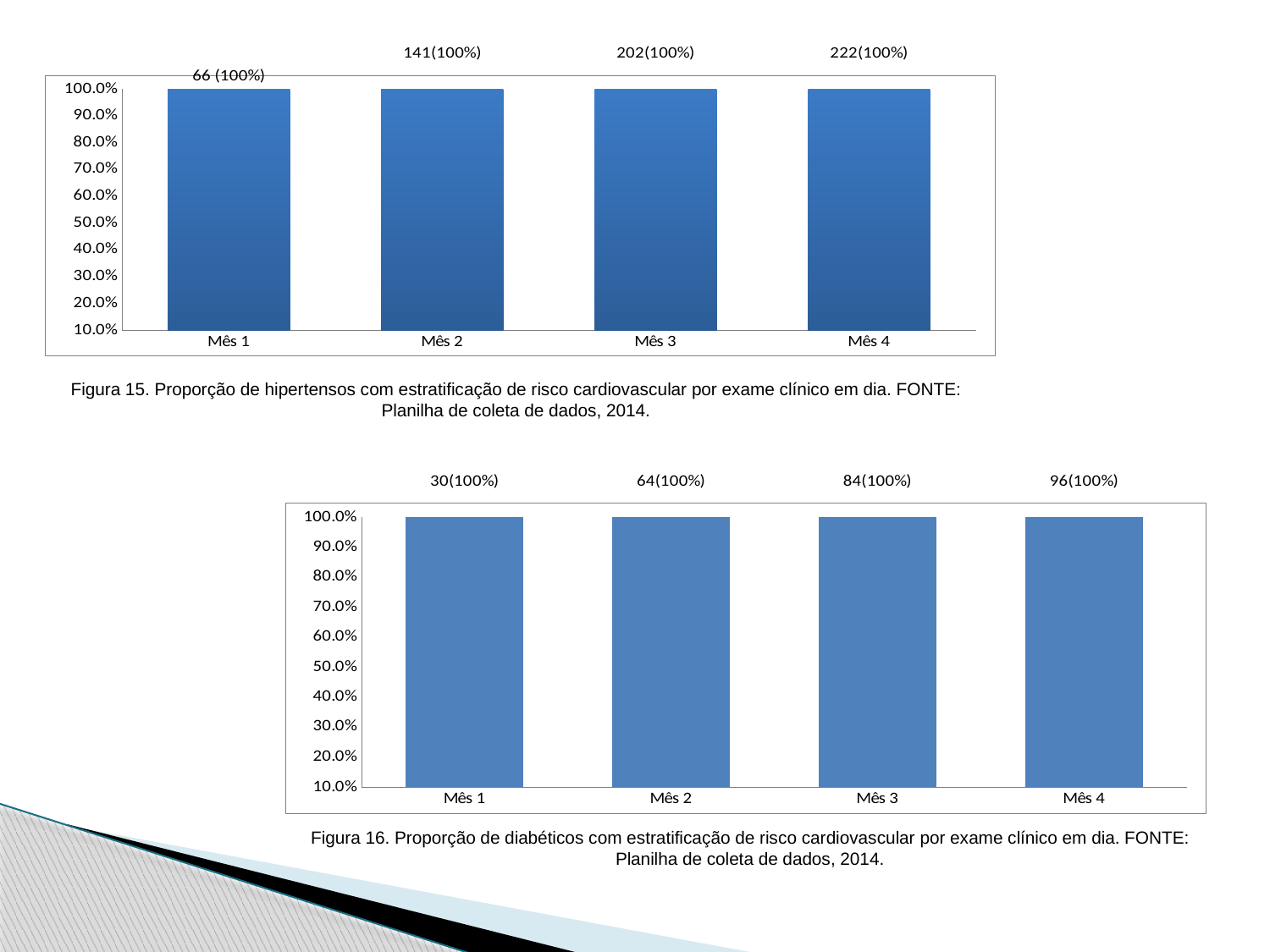
How many categories (months) are shown on the x axis of the top chart (Figura 15)? 4 What kind of chart is the bottom chart (Figura 16)? Bar chart In the bottom chart (Figura 16), what is the data label shown above the bar for Mês 3? 84(100%) In the top chart (Figura 15), what is the data label shown above the bar for Mês 2? 141(100%) In the top chart (Figura 15), what is the data label shown above the bar for Mês 1? 66 (100%) In the bottom chart (Figura 16), what is the data label shown above the bar for Mês 1? 30(100%) In the bottom chart (Figura 16), do the bar heights rise, fall, or stay the same from Mês 1 to Mês 4? Stay the same In the top chart (Figura 15), is the bar for Mês 3 greater or less than 50.0%? greater In the top chart (Figura 15), what percentage does every bar reach? 100.0% In the bottom chart (Figura 16), what is the data label shown above the bar for Mês 4? 96(100%) What is the caption (figure title) of the bottom chart? Figura 16. Proporção de diabéticos com estratificação de risco cardiovascular por exame clínico em dia. In the top chart (Figura 15), what is the data label shown above the bar for Mês 4? 222(100%)